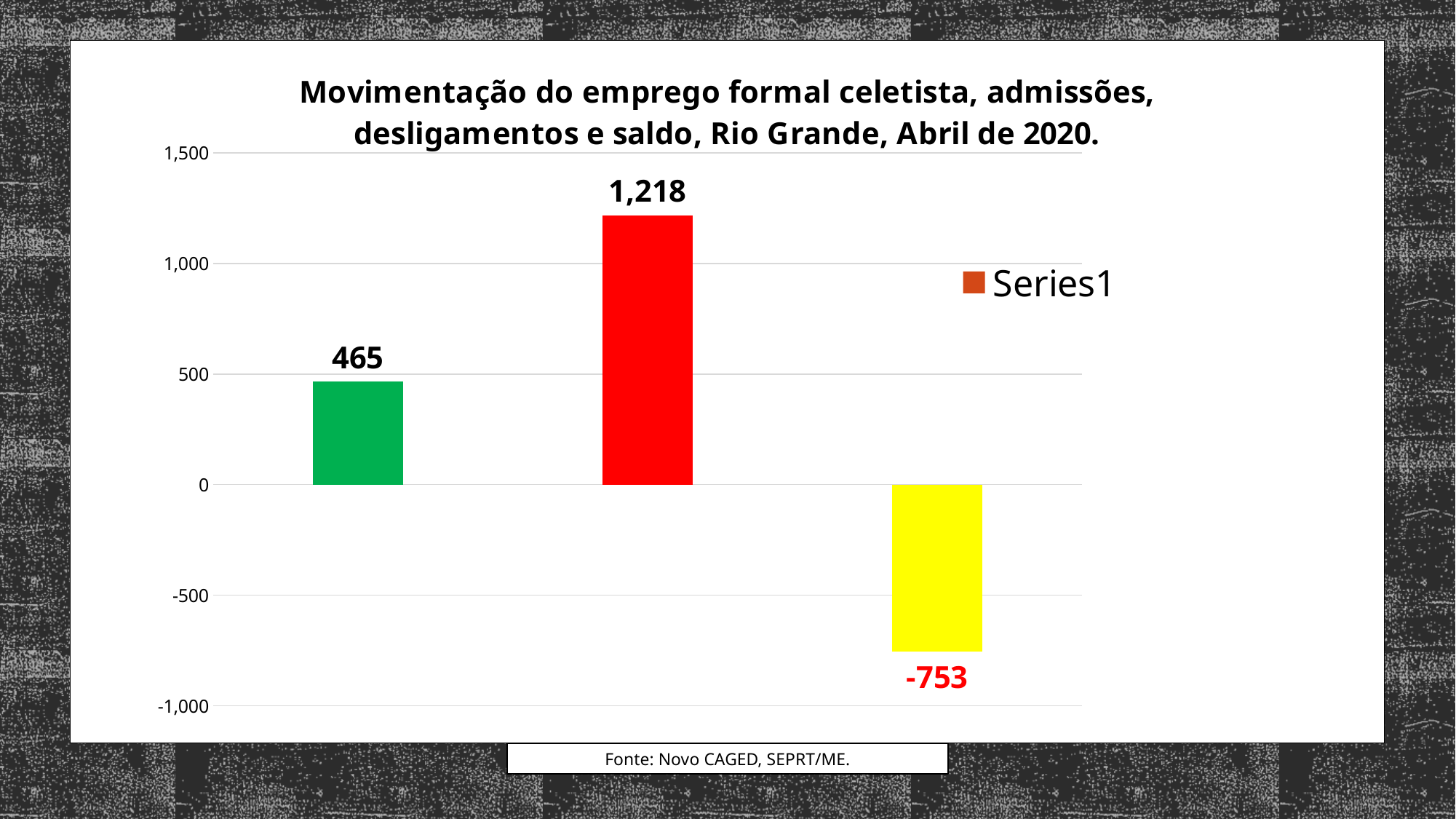
What value is shown on the red bar? 1,218 Which bar has the lowest value: the green, red or yellow bar? yellow How many bars are plotted in the chart? 3 How many series does the legend list? 1 What value is shown on the yellow bar? -753 Which is larger, the value of the green bar or the value of the red bar? red bar What value is shown on the green bar? 465 What is the difference between the red bar's value and the green bar's value? 753 Is the value of the red bar greater or less than 1,000? greater What is the name of the series shown in the legend? Series1 Which bar has the highest value: the green, red or yellow bar? red What kind of chart is shown on the slide? bar chart